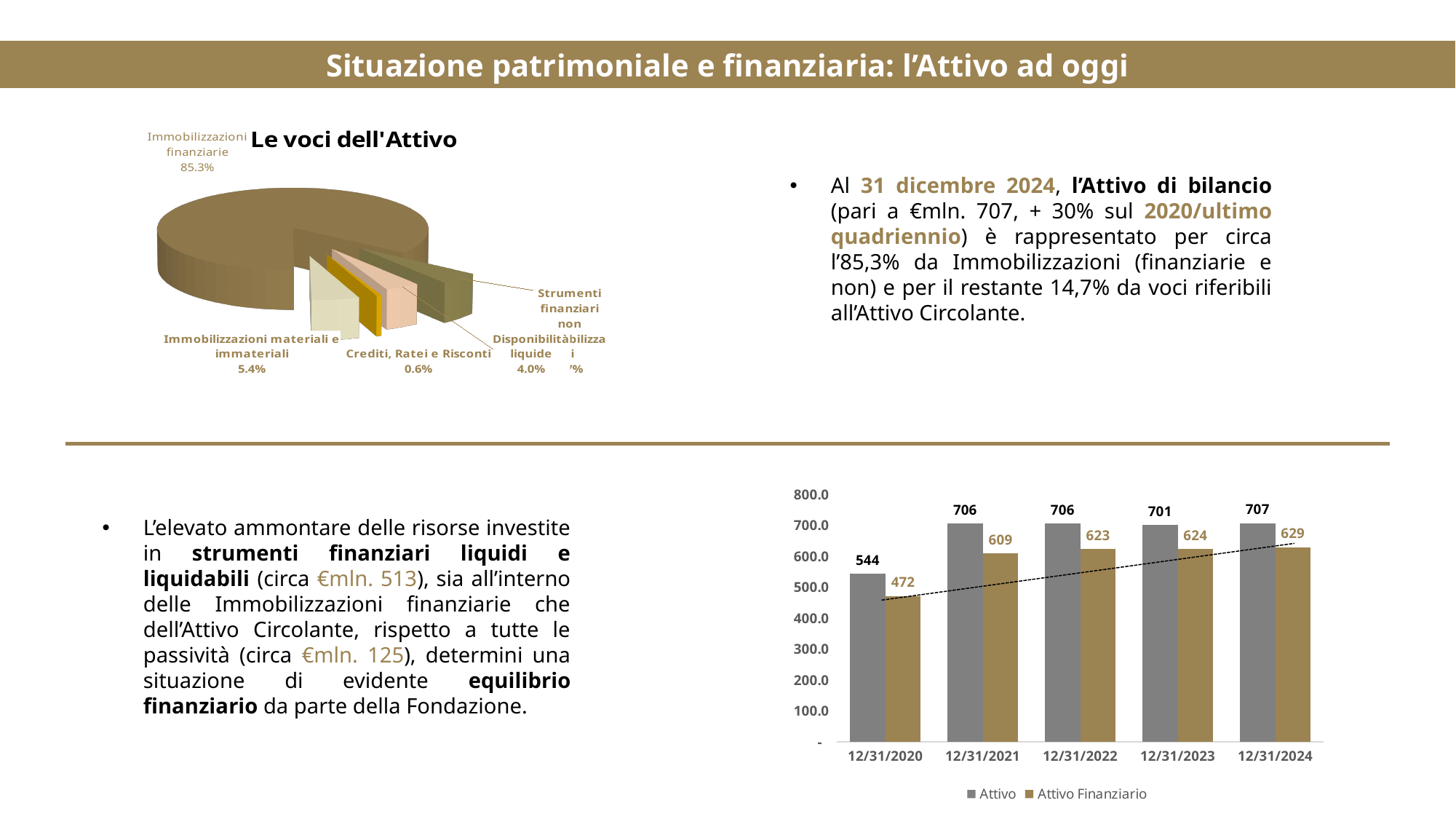
In the bar chart at the bottom right, in which year is Attivo lowest? 12/31/2020 In the bar chart at the bottom right, how many series does the legend list? 2 In the pie chart 'Le voci dell'Attivo', which slice is the largest? Immobilizzazioni finanziarie In the bar chart at the bottom right, what is the difference between Attivo and Attivo Finanziario at 12/31/2022? 83 In the pie chart 'Le voci dell'Attivo', which is larger: Immobilizzazioni materiali e immateriali or Crediti, Ratei e Risconti? Immobilizzazioni materiali e immateriali In the pie chart 'Le voci dell'Attivo', what share is Immobilizzazioni materiali e immateriali? 5.4% In the bar chart at the bottom right, does Attivo Finanziario rise or fall from 12/31/2020 to 12/31/2024? rise In the pie chart 'Le voci dell'Attivo', what share is Immobilizzazioni finanziarie? 85.3% In the bar chart at the bottom right, what is the value of Attivo at 12/31/2024? 707 In the pie chart 'Le voci dell'Attivo', what share is Disponibilità liquide? 4.0% In the bar chart at the bottom right, how many dates are shown on the x axis? 5 In the bar chart at the bottom right, what is the value of Attivo Finanziario at 12/31/2020? 472